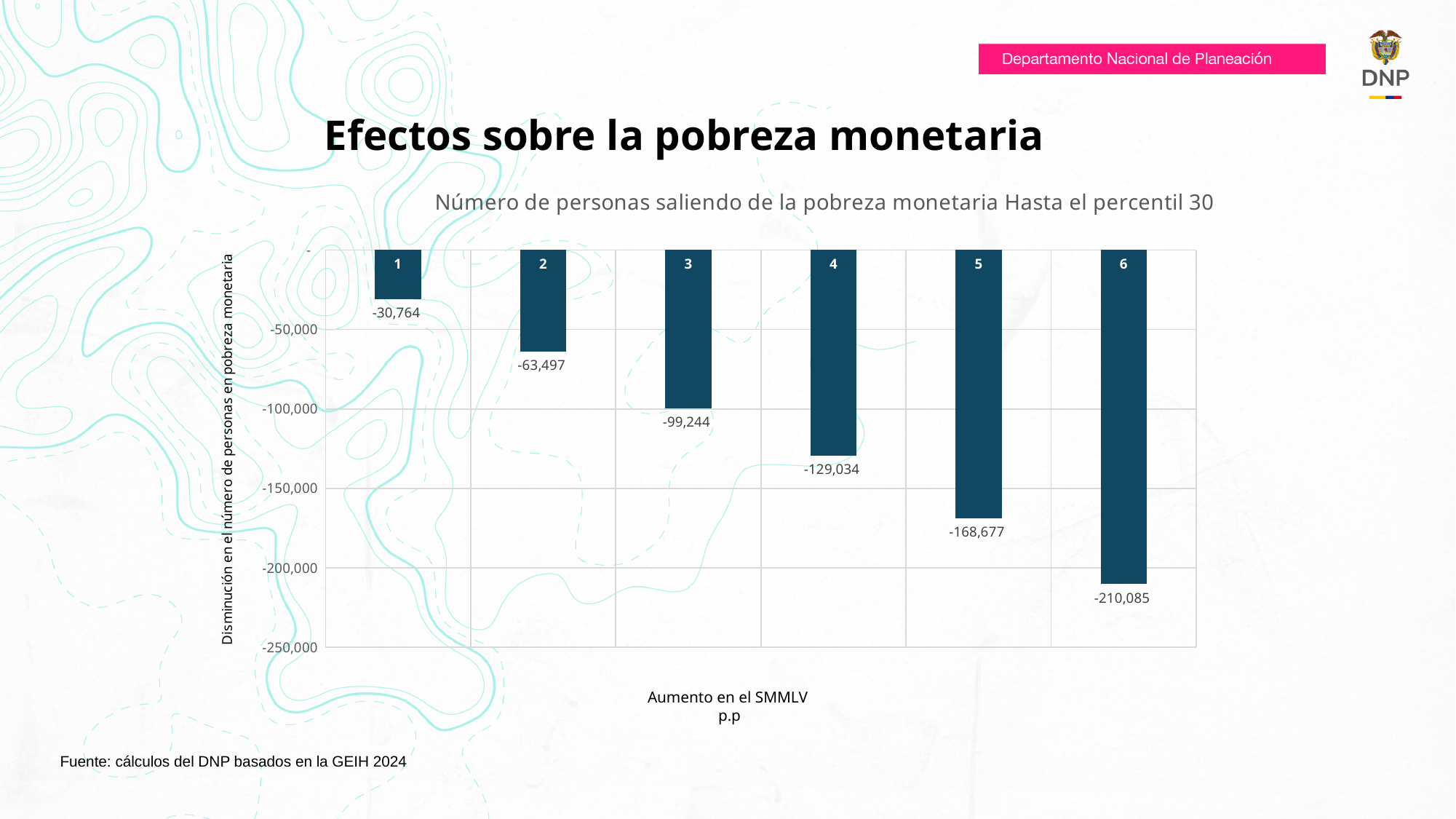
What is the value for category 6? -210,085 How many categories are shown on the x axis? 6 What is the difference between the values for category 6 and category 5? 41,408 Which has a larger decrease in magnitude, category 3 or category 5? 5 Do the values rise or fall as the category number increases along the x axis? fall Is the value for category 4 greater or less than -100,000? less Which category has the highest (least negative) value? 1 What kind of chart is shown on the slide? bar chart What is the difference between the values for category 2 and category 1? 32,733 What is the value for category 1? -30,764 Which category has the lowest (most negative) value? 6 What is the value for category 4? -129,034